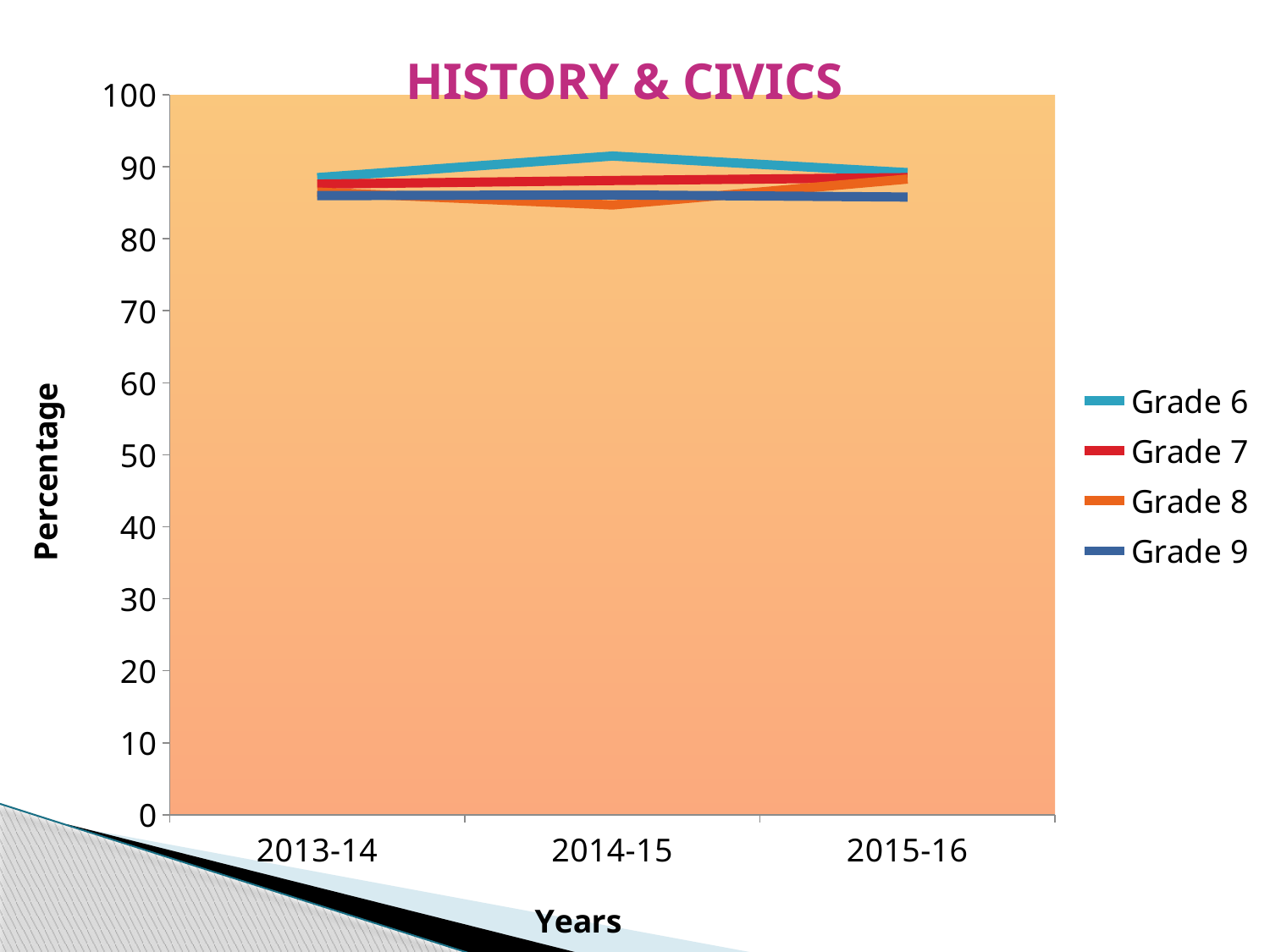
Is the value for Grade 9 in 2013-14 greater or less than 80? greater What is the label of the vertical axis? Percentage Which is larger in 2014-15, the value for Grade 6 or the value for Grade 9? Grade 6 Is the value for Grade 8 in 2014-15 greater or less than 90? less What kind of chart is shown on the slide? line chart How many years are shown on the x axis? 3 Which grade has the highest value in 2014-15? Grade 6 What is the title of the chart? HISTORY & CIVICS How many series does the legend list? 4 Does the Grade 8 line rise or fall from 2014-15 to 2015-16? rise Is the value for Grade 6 in 2014-15 greater or less than 90? greater Which is larger in 2014-15, the value for Grade 7 or the value for Grade 8? Grade 7